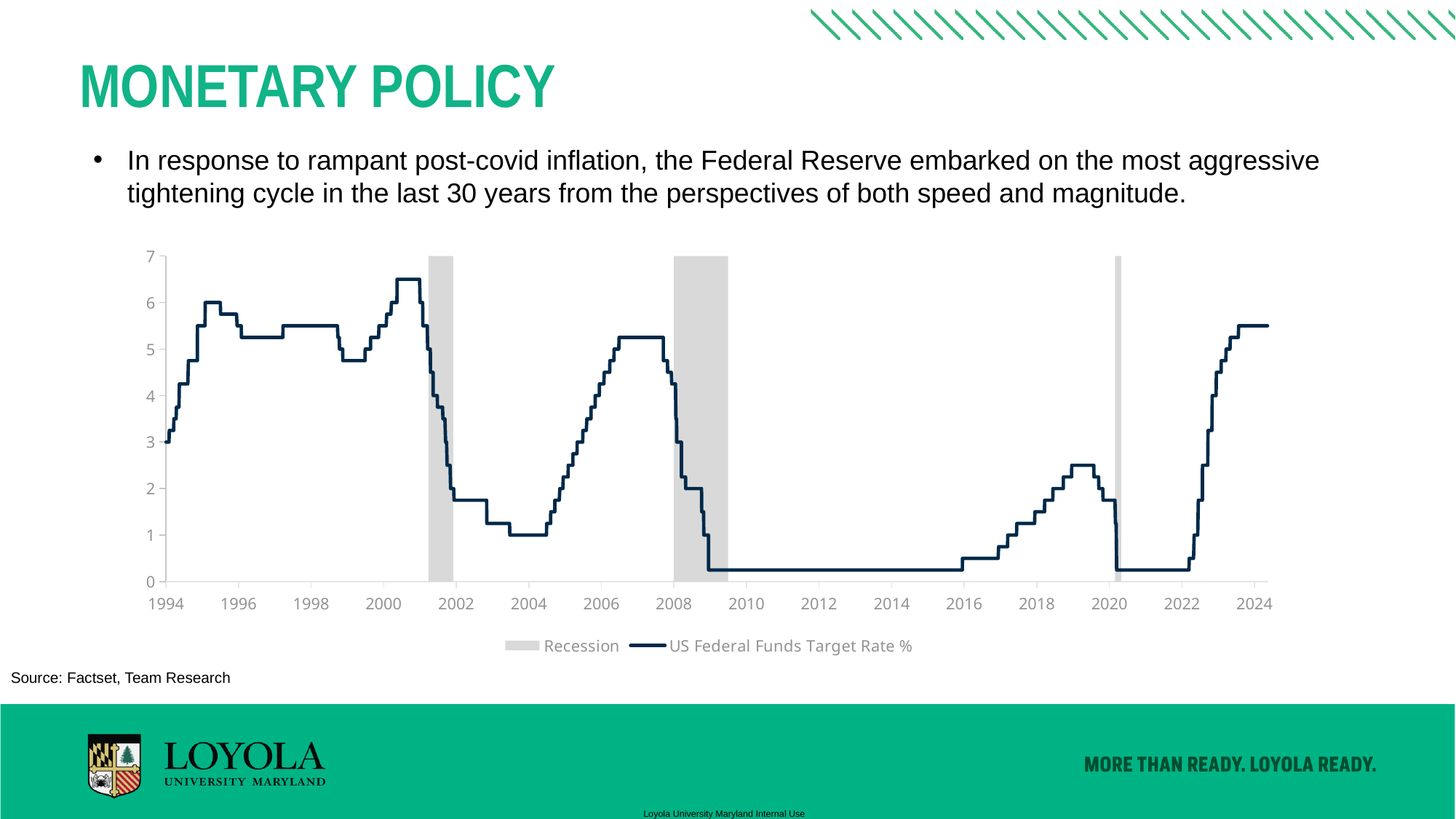
Does the US Federal Funds Target Rate rise or fall between 2022 and 2024? rise Which is larger, the US Federal Funds Target Rate in 2024 or in 2012? 2024 How many shaded recession periods are shown on the chart? 3 Is the US Federal Funds Target Rate in 2012 greater or less than 1? less Does the US Federal Funds Target Rate rise or fall between 2007 and 2009? fall Is the peak of the US Federal Funds Target Rate around 2000 greater or less than 6? greater What kind of chart is shown on the slide? line chart Is the US Federal Funds Target Rate in 2004 greater or less than 2? less How many entries does the chart legend list? 2 What is the US Federal Funds Target Rate at the start of 1994? 3 What are the two entries in the chart legend? Recession and US Federal Funds Target Rate %